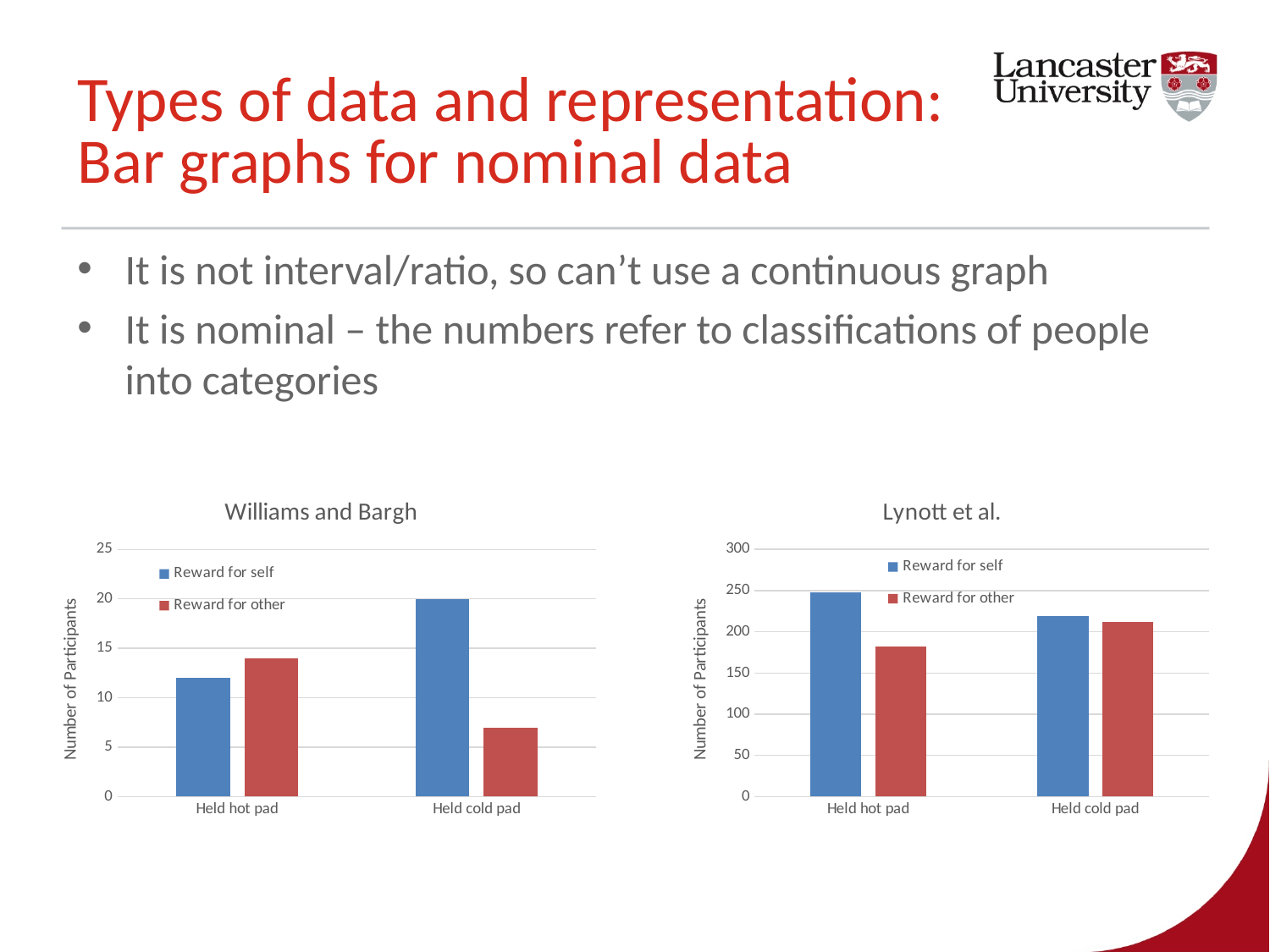
In the Williams and Bargh chart, which bar is the highest? Reward for self, Held cold pad In the Williams and Bargh chart, is the value for Reward for other in the Held cold pad category greater or less than 10? less In the Williams and Bargh chart, which bar is the lowest? Reward for other, Held cold pad How many categories are shown on the x axis of the Williams and Bargh chart? 2 In the Lynott et al. chart, which is larger for Held hot pad: Reward for self or Reward for other? Reward for self In the Williams and Bargh chart, what is the value for Reward for self in the Held cold pad category? 20 In the Lynott et al. chart, is the value for Reward for self in the Held hot pad category greater or less than 200? greater What is the y-axis label of the Lynott et al. chart? Number of Participants In the Williams and Bargh chart, is the value for Reward for self in the Held hot pad category greater or less than 10? greater What kind of chart is the Williams and Bargh chart? bar chart How many series does the legend of the Lynott et al. chart list? 2